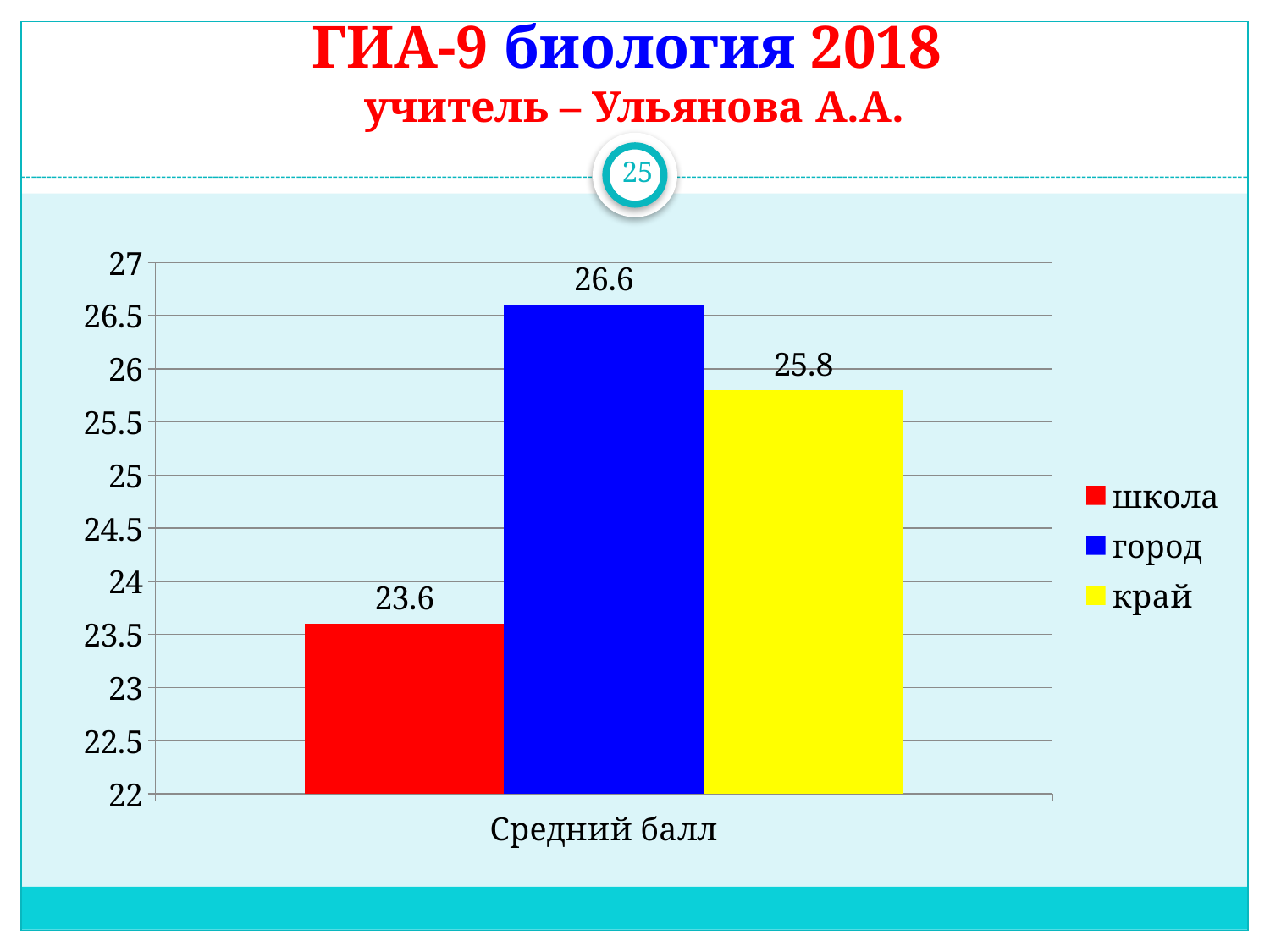
Which is larger, the value for край or the value for школа? край Which series has the lowest value? школа What is the difference between the values for город and школа? 3 What is the value for город in the chart? 26.6 What is the label on the x axis of the chart? Средний балл Is the value for город greater or less than 26? greater What is the difference between the values for край and школа? 2.2 What kind of chart is shown on the slide? bar chart What is the value for школа in the chart? 23.6 What is the value for край in the chart? 25.8 Which series has the highest value? город How many series does the legend list? 3